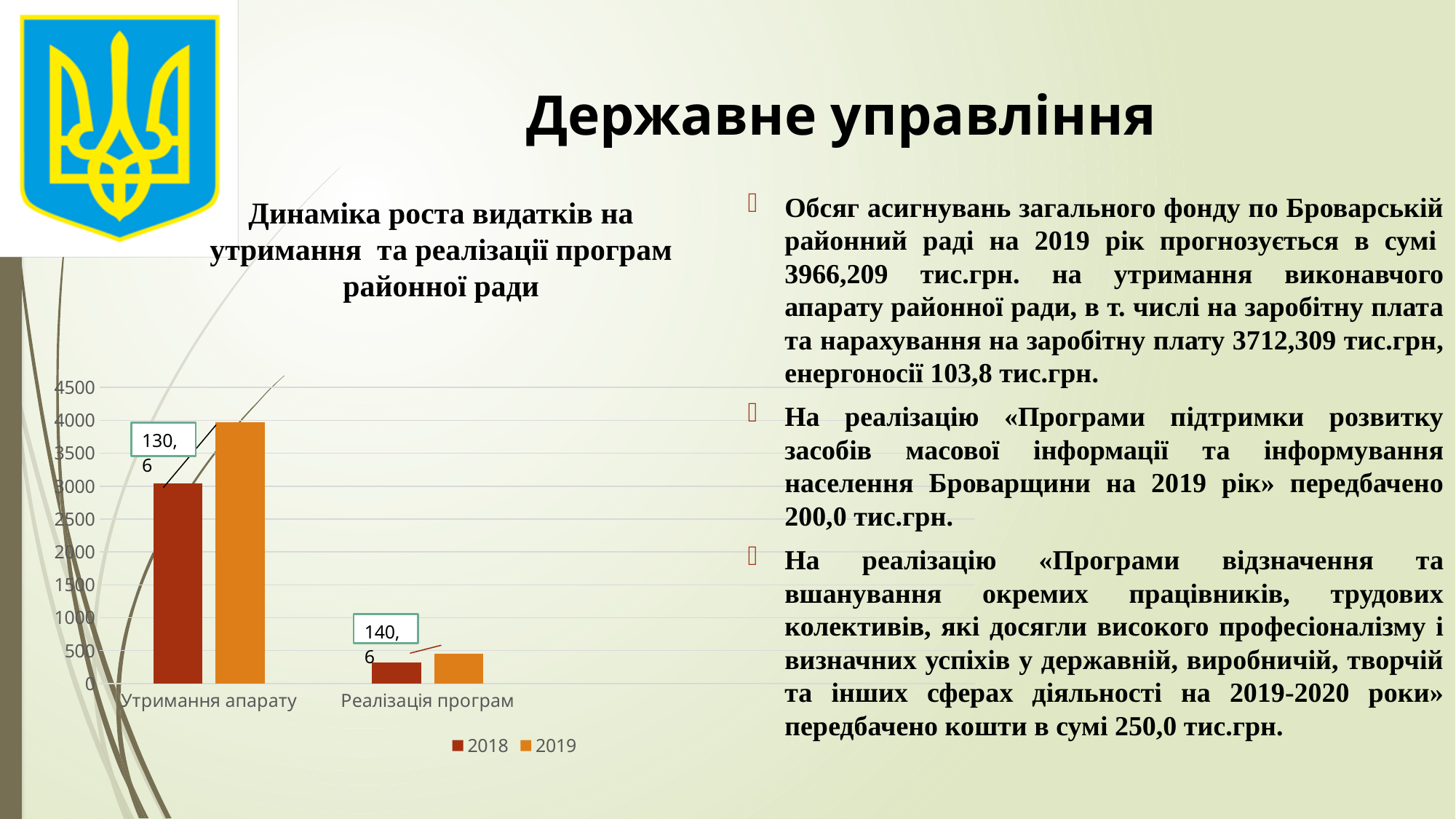
For Утримання апарату, which series has the larger bar, 2018 or 2019? 2019 Is the 2018 value for Утримання апарату greater or less than 3500? less Which category has the highest 2019 bar? Утримання апарату What are the series names listed in the chart legend? 2018 and 2019 Which category has the lowest 2018 bar? Реалізація програм Is the 2019 value for Утримання апарату greater or less than 3500? greater What kind of chart is shown on the slide? bar chart How many categories are shown on the x axis of the chart? 2 How many series does the chart legend list? 2 For Реалізація програм, which series has the larger bar, 2018 or 2019? 2019 Is the 2019 value for Реалізація програм greater or less than 1000? less Which colour represents the 2019 series in the chart? orange